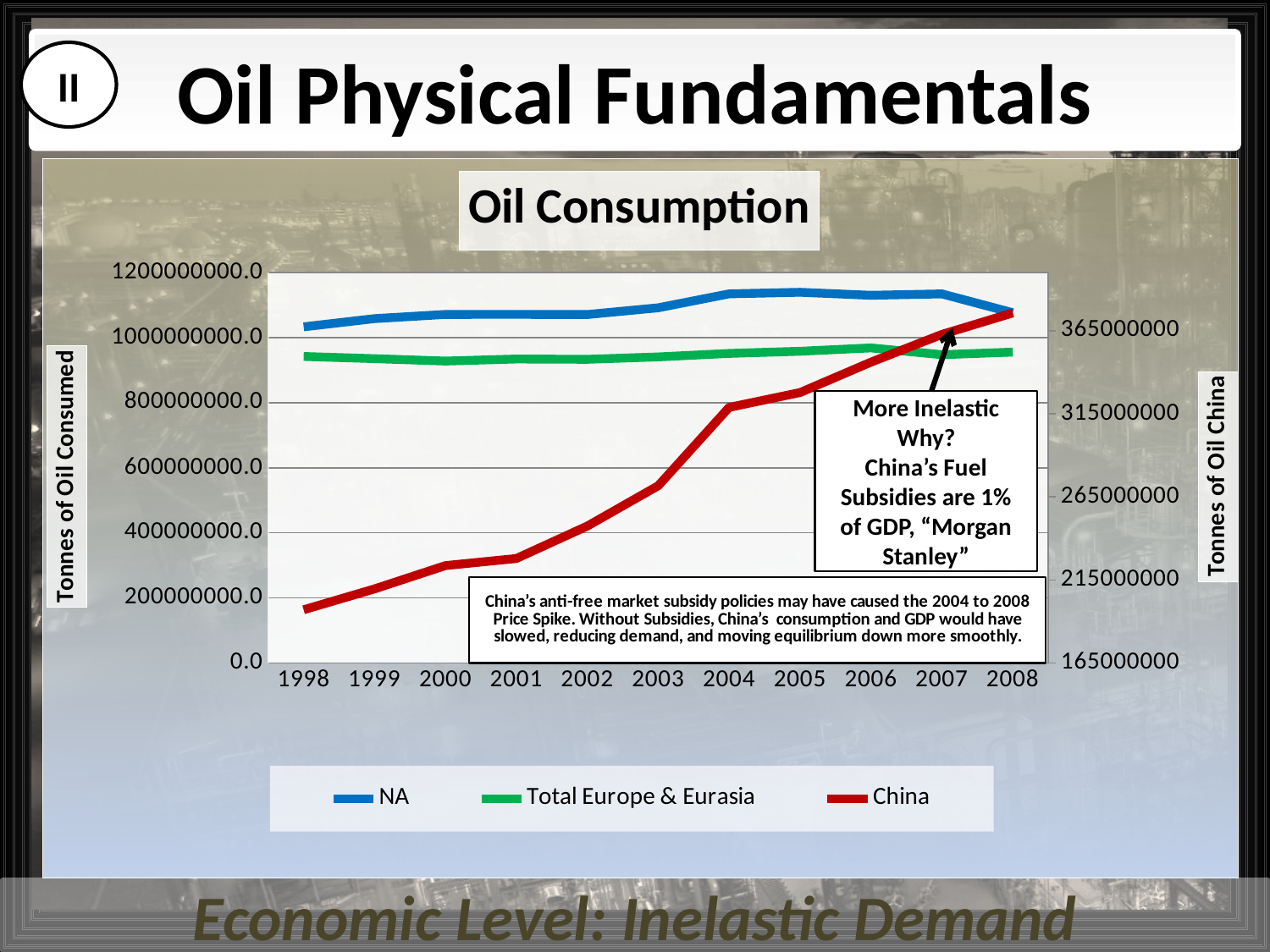
Which series has the highest line on the chart across the years shown, NA or Total Europe & Eurasia? NA Does the China line rise or fall from 1998 to 2008? rise What is the first year shown on the x axis of the chart? 1998 Is the value for Total Europe & Eurasia in 2006 greater or less than 800000000.0 on the left axis? greater Which series are listed in the chart legend? NA, Total Europe & Eurasia, China How many years are shown along the x axis of the chart? 11 Is the value for Total Europe & Eurasia in 2000 greater or less than 1000000000.0 on the left axis? less What kind of chart is shown on the slide? line chart Is the value for NA in 2004 greater or less than 1000000000.0 on the left axis? greater How many series does the chart legend list? 3 What is the title of the chart? Oil Consumption What is the last year shown on the x axis of the chart? 2008